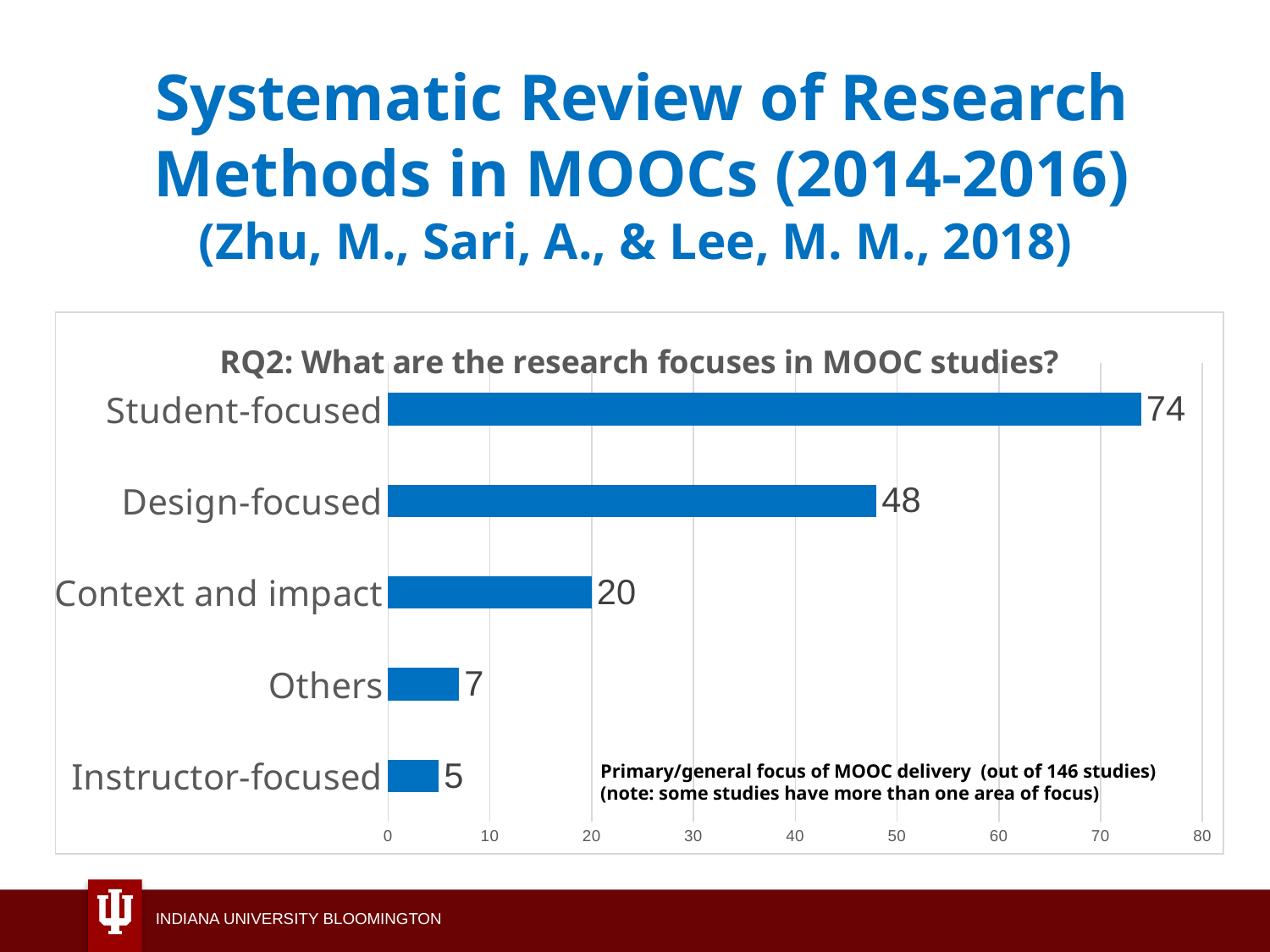
What is the difference between the values for Others and Instructor-focused? 2 What is the value for Context and impact? 20 Which category has the lowest value? Instructor-focused How many categories are shown in the chart? 5 What is the difference between the values for Student-focused and Design-focused? 26 What is the value for Instructor-focused? 5 What is the title of the chart? RQ2: What are the research focuses in MOOC studies? Which category has the highest value? Student-focused What is the value for Student-focused? 74 Which is larger, the value for Context and impact or the value for Others? Context and impact What kind of chart is shown on the slide? Bar chart What is the value for Design-focused? 48